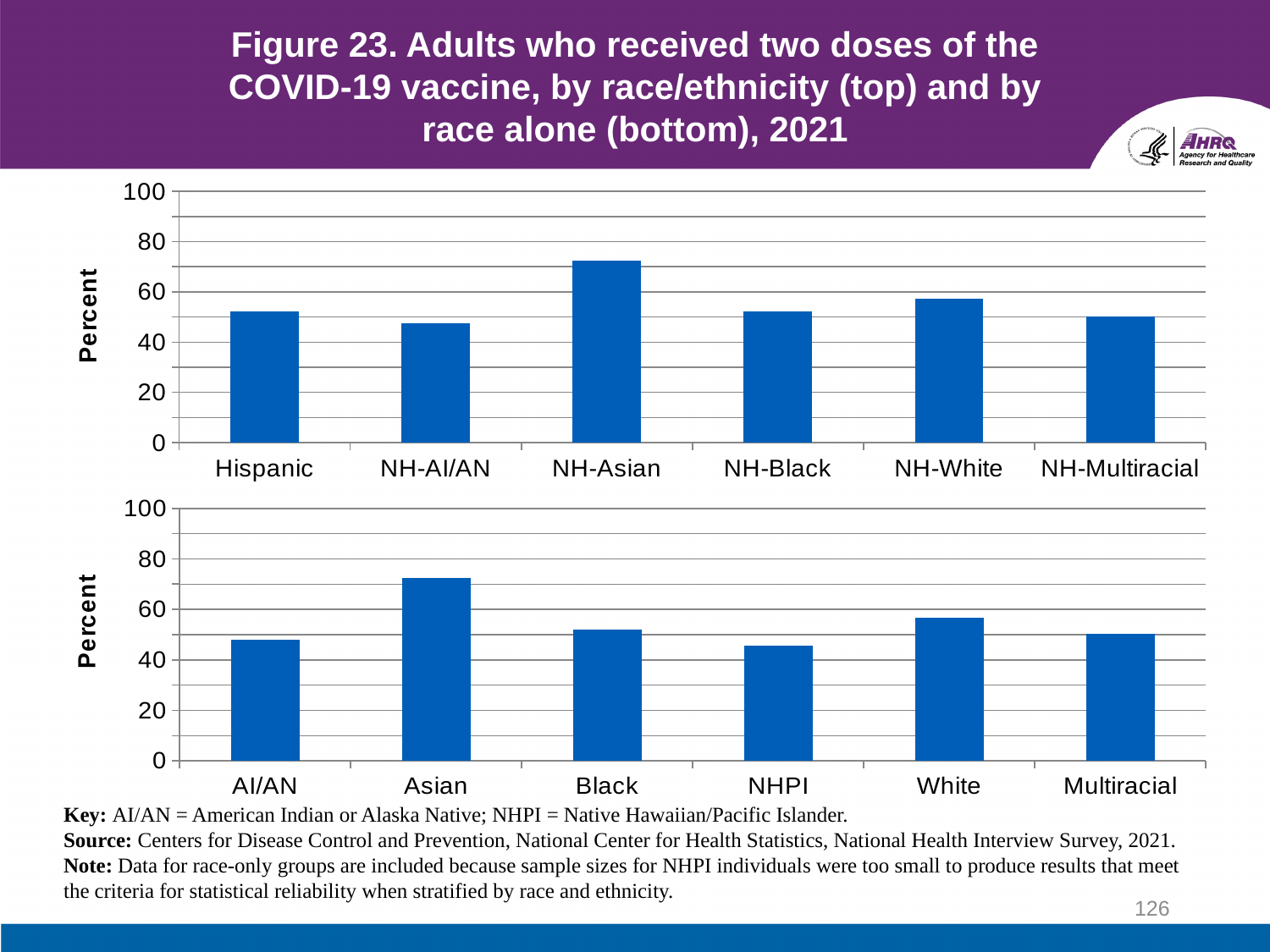
In the bottom chart, which is larger, the value for White or NHPI? White In the top chart, is the value for NH-Asian greater or less than 60? greater In the top chart (by race/ethnicity), which group has the highest percentage? NH-Asian In the bottom chart, which is larger, the value for Asian or Black? Asian In the bottom chart, is the value for Asian greater or less than 60? greater What is the label on the vertical axis of the top chart? Percent In the bottom chart, is the value for NHPI greater or less than 50? less In the top chart, which is larger, the value for NH-Asian or NH-White? NH-Asian What kind of chart is the bottom chart? Bar chart In the bottom chart (by race alone), which group has the highest percentage? Asian How many categories are shown in the top chart? 6